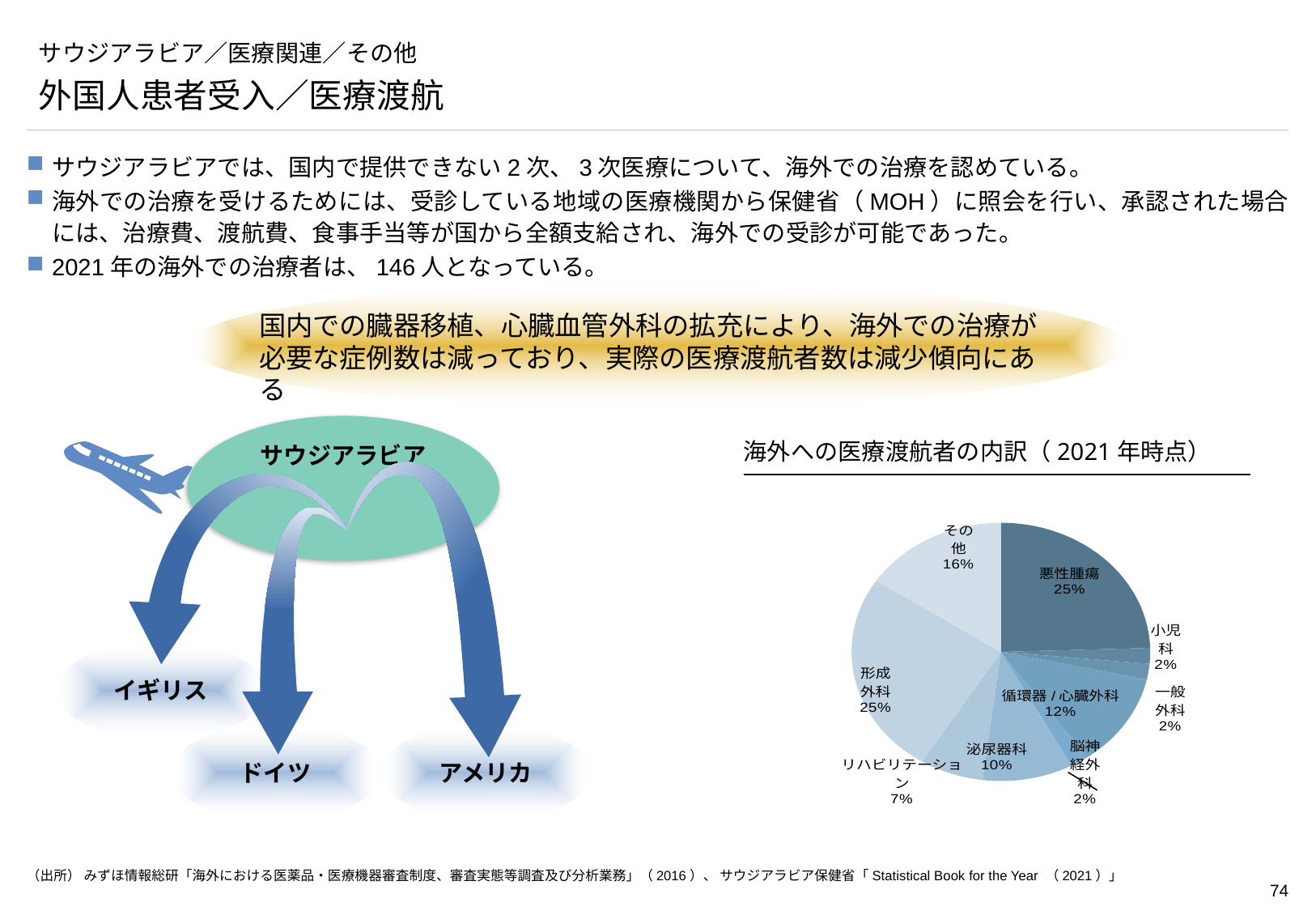
In the pie chart 海外への医療渡航者の内訳, what share is labelled for リハビリテーション? 7% In the pie chart 海外への医療渡航者の内訳, what share is labelled for 泌尿器科? 10% In the pie chart 海外への医療渡航者の内訳, what share is labelled for その他? 16% In the pie chart 海外への医療渡航者の内訳, how many slices (categories) are shown? 9 What year does the pie chart title 海外への医療渡航者の内訳 refer to? 2021年 In the pie chart 海外への医療渡航者の内訳, what share is labelled for 悪性腫瘍? 25% In the pie chart 海外への医療渡航者の内訳, what share is labelled for 小児科? 2% In the pie chart 海外への医療渡航者の内訳, what share is labelled for 循環器/心臓外科? 12% In the pie chart 海外への医療渡航者の内訳, what is the difference between the shares of その他 and リハビリテーション? 9 percentage points In the pie chart 海外への医療渡航者の内訳, what share is labelled for 形成外科? 25% What kind of chart is shown under the title 海外への医療渡航者の内訳（2021年時点）? Pie chart In the pie chart 海外への医療渡航者の内訳, which is larger: 循環器/心臓外科 or 泌尿器科? 循環器/心臓外科